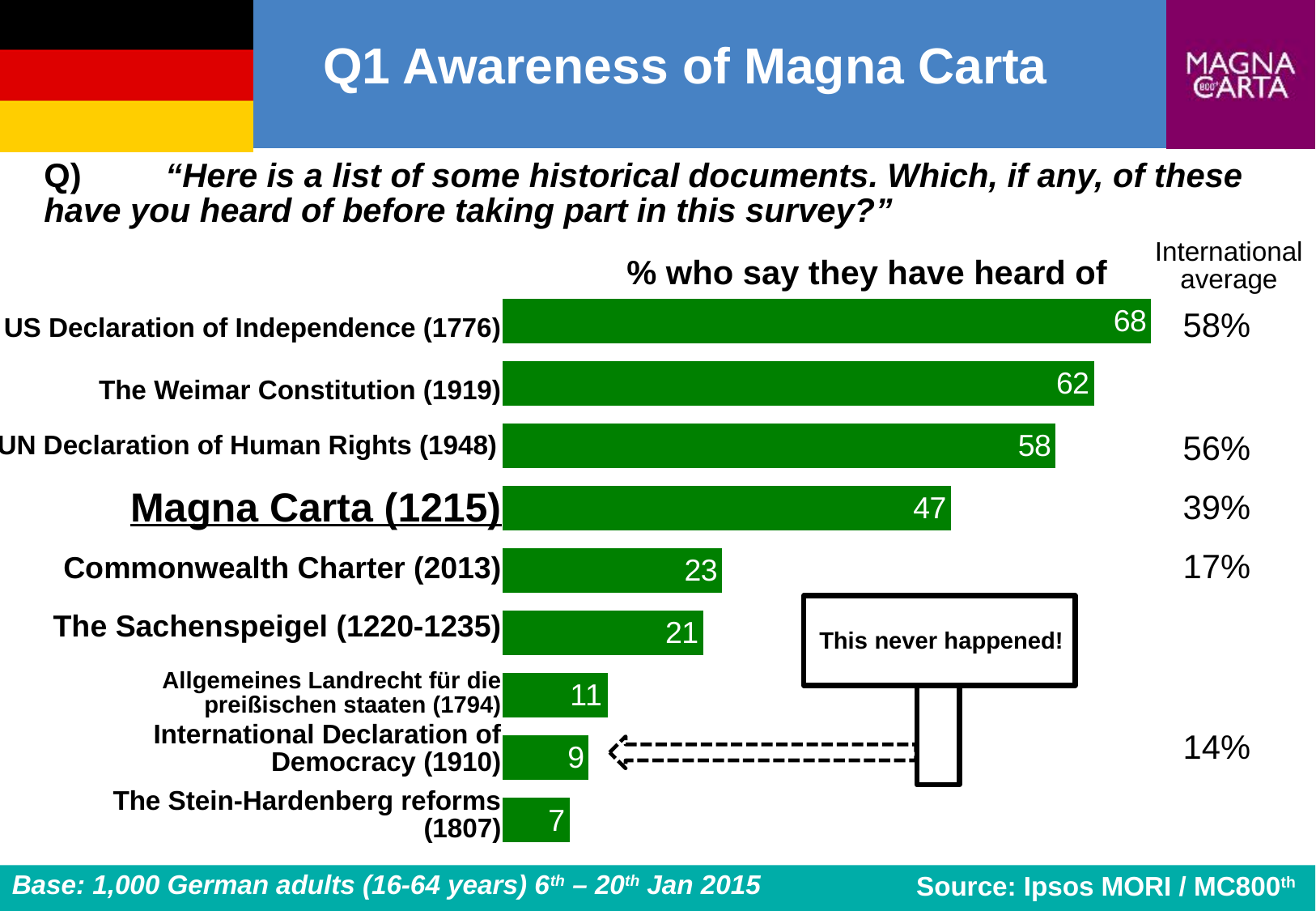
What does the callout box pointing to the International Declaration of Democracy (1910) bar say? This never happened! What value is shown for The Sachenspeigel (1220-1235)? 21 What kind of chart is shown on the slide? Bar chart What value is shown for Magna Carta (1215)? 47 Which document has the lowest percentage of people who say they have heard of it? The Stein-Hardenberg reforms (1807) What is the difference between the values for UN Declaration of Human Rights (1948) and The Stein-Hardenberg reforms (1807)? 51 What is the difference between the values for The Weimar Constitution (1919) and Magna Carta (1215)? 15 What percentage of German adults say they have heard of the US Declaration of Independence (1776)? 68 What is the international average shown for Magna Carta (1215)? 39% Which document has the highest percentage of people who say they have heard of it? US Declaration of Independence (1776) Which has a higher value: Commonwealth Charter (2013) or The Sachenspeigel (1220-1235)? Commonwealth Charter (2013) How many documents are listed in the chart? 9